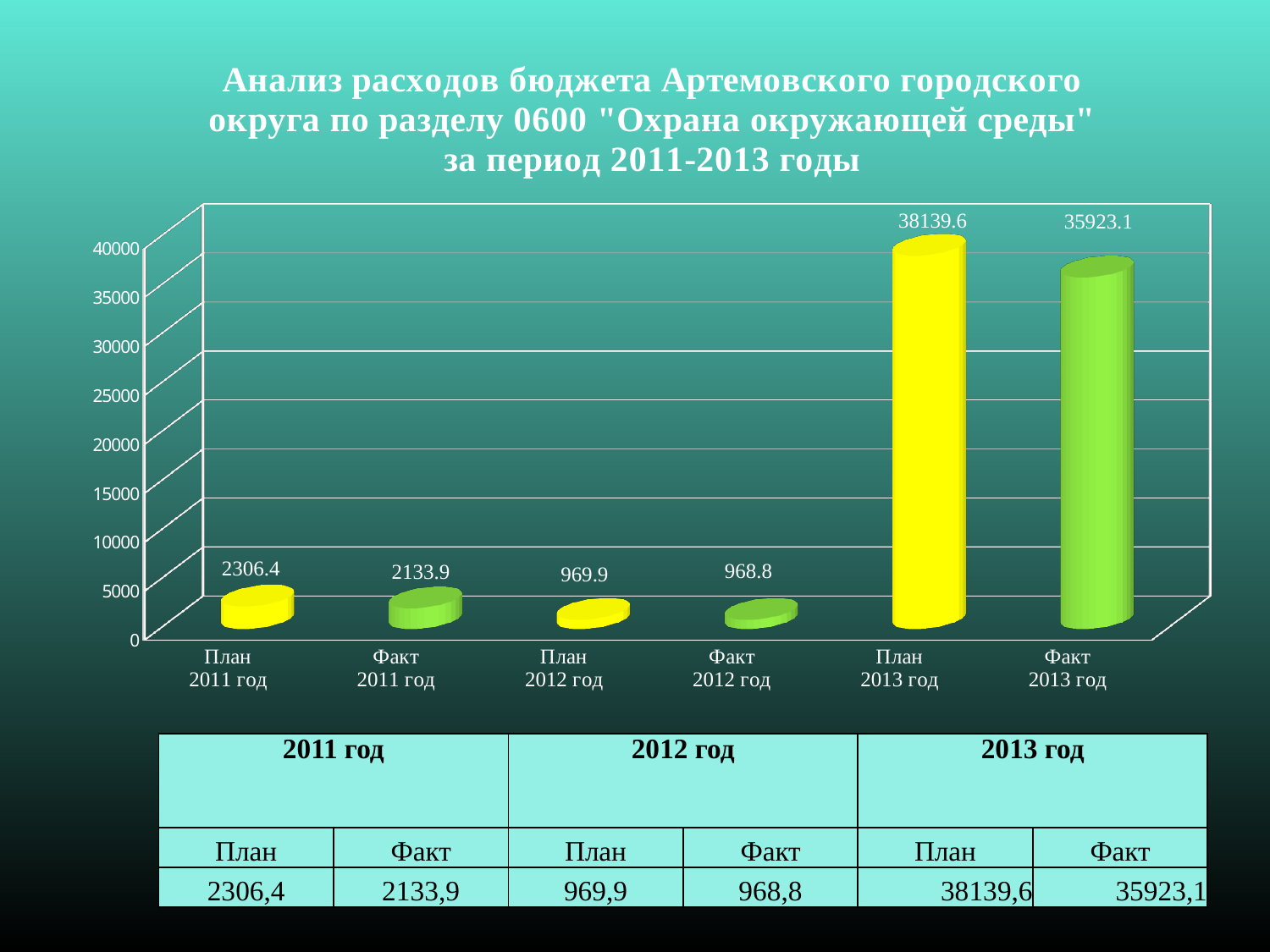
What is the difference between План 2013 год and Факт 2013 год? 2216.5 What is the difference between План 2011 год and Факт 2011 год? 172.5 What kind of chart is shown on the slide? bar chart What is the value for Факт 2012 год? 968.8 Which is larger, План 2011 год or Факт 2011 год? План 2011 год What is the value for План 2011 год? 2306.4 Which category has the lowest value? Факт 2012 год Is the value for Факт 2013 год greater or less than 30000? greater What is the value for Факт 2013 год? 35923.1 How many bars are plotted in the chart? 6 What is the highest value shown on the vertical axis? 40000 Which category has the highest value? План 2013 год